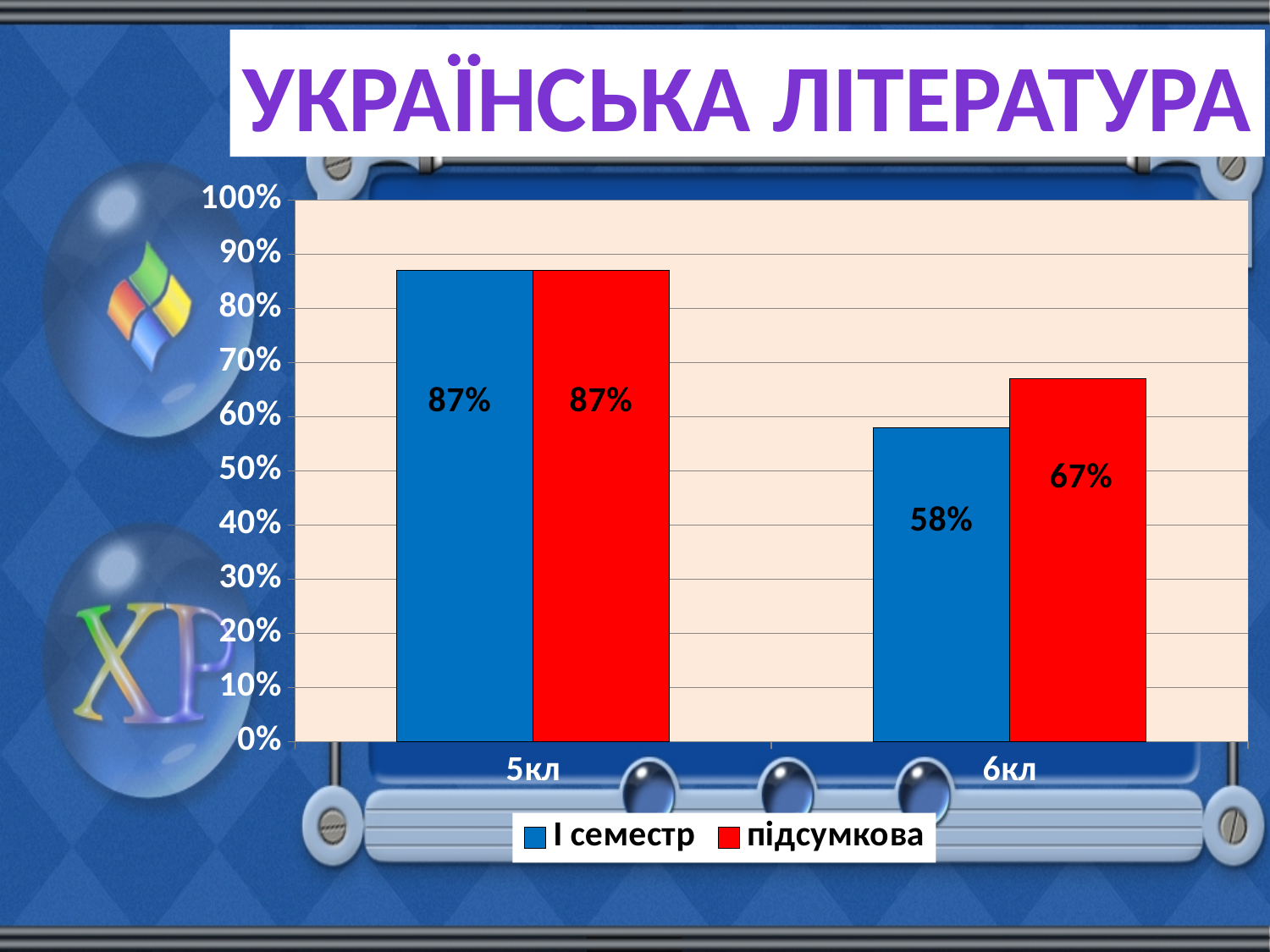
Which is larger for 6кл: І семестр or підсумкова? підсумкова How many series does the legend list? 2 What is the value for підсумкова in 6кл? 67% What is the value for І семестр in 6кл? 58% Is the value for І семестр in 6кл greater or less than 50%? greater How many categories are shown on the x axis? 2 What is the value for І семестр in 5кл? 87% What is the title of the slide? УКРАЇНСЬКА ЛІТЕРАТУРА What is the value for підсумкова in 5кл? 87% What is the difference between the підсумкова and І семестр values for 6кл? 9% What kind of chart is shown on the slide? bar chart Which category has the lowest value for І семестр? 6кл